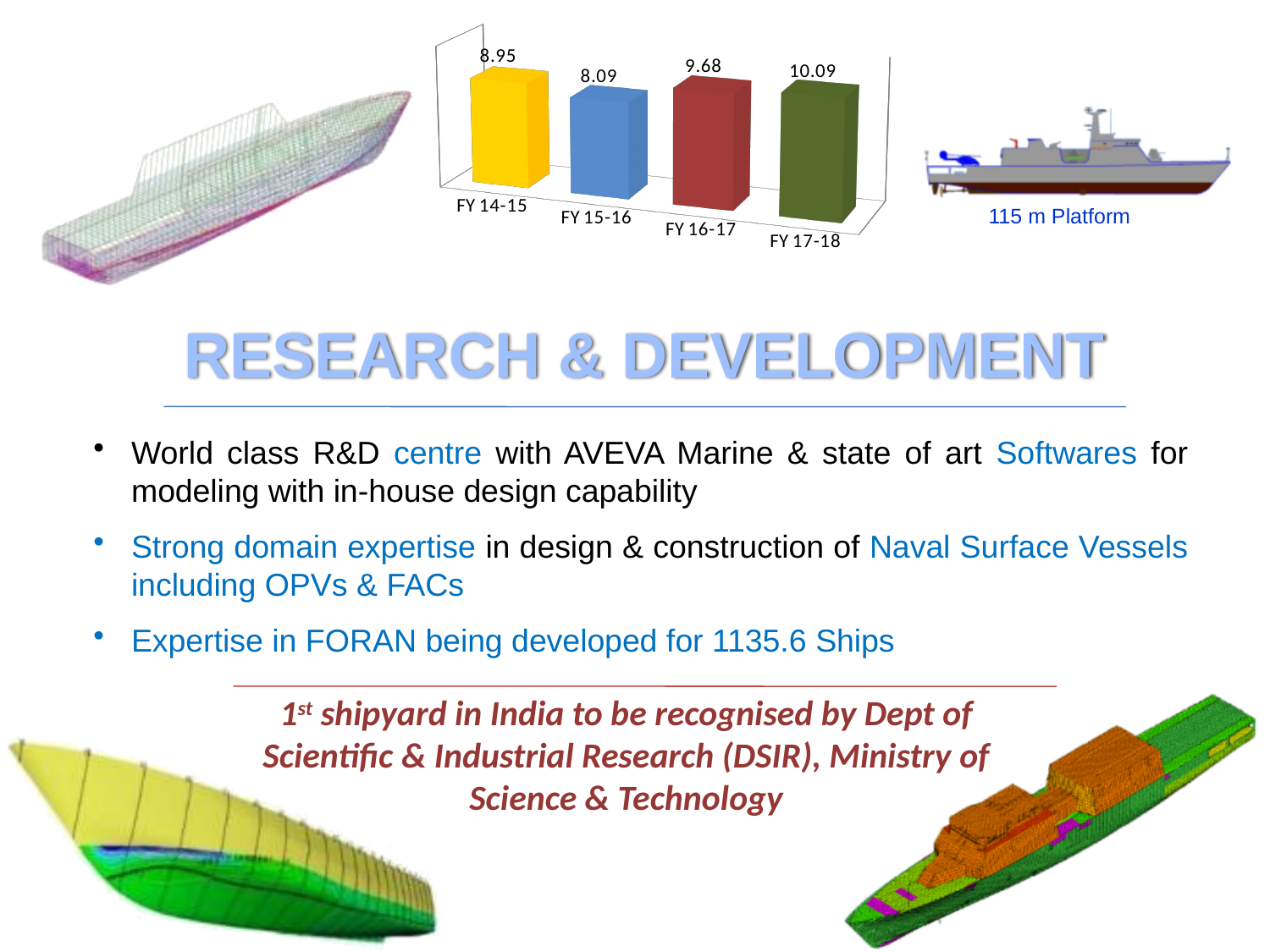
What is the value for FY 14-15? 8.95 Which fiscal year has the lowest value? FY 15-16 What is the difference between the values for FY 17-18 and FY 16-17? 0.41 How many fiscal years are shown in the chart? 4 What is the value for FY 15-16? 8.09 Which fiscal year has the highest value? FY 17-18 What kind of chart is shown on the slide? Bar chart What is the difference between the values for FY 14-15 and FY 15-16? 0.86 What colour is the bar for FY 14-15? Yellow What is the value for FY 17-18? 10.09 What is the value for FY 16-17? 9.68 Which is larger, the value for FY 14-15 or FY 16-17? FY 16-17